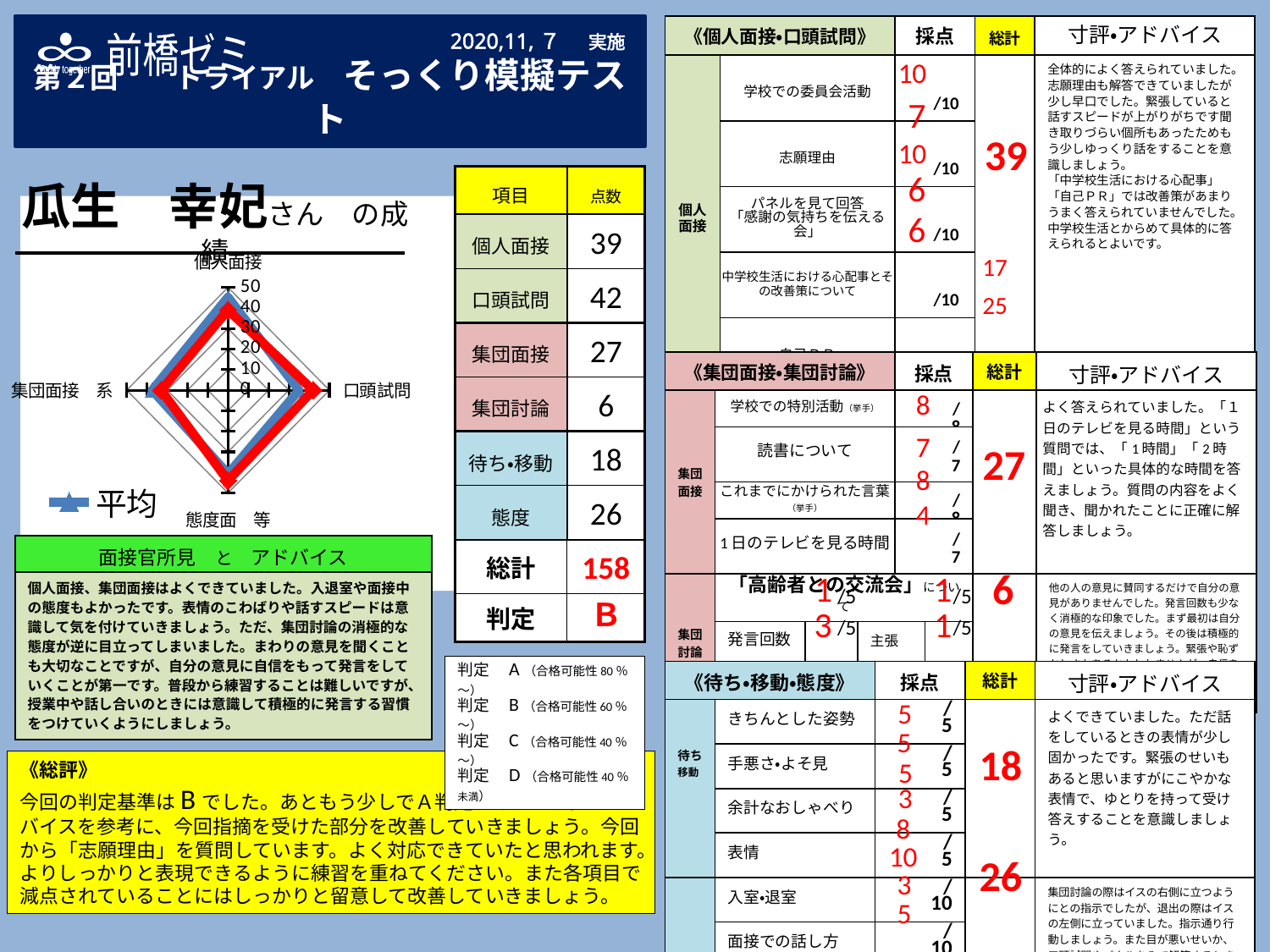
Which category label appears at the top of the radar chart? 個人面接 What legend entry is shown below the radar chart? 平均 How many axes (categories) does the radar chart have? 4 On the radar chart, is the red series value for 口頭試問 greater or less than 30? greater On the radar chart, is the red series value for 個人面接 greater or less than 50? less What kind of chart is shown on the left of the slide? radar chart On the radar chart, is the red series value for 個人面接 greater or less than 30? greater What is the highest tick value shown on the radar chart's axis? 50